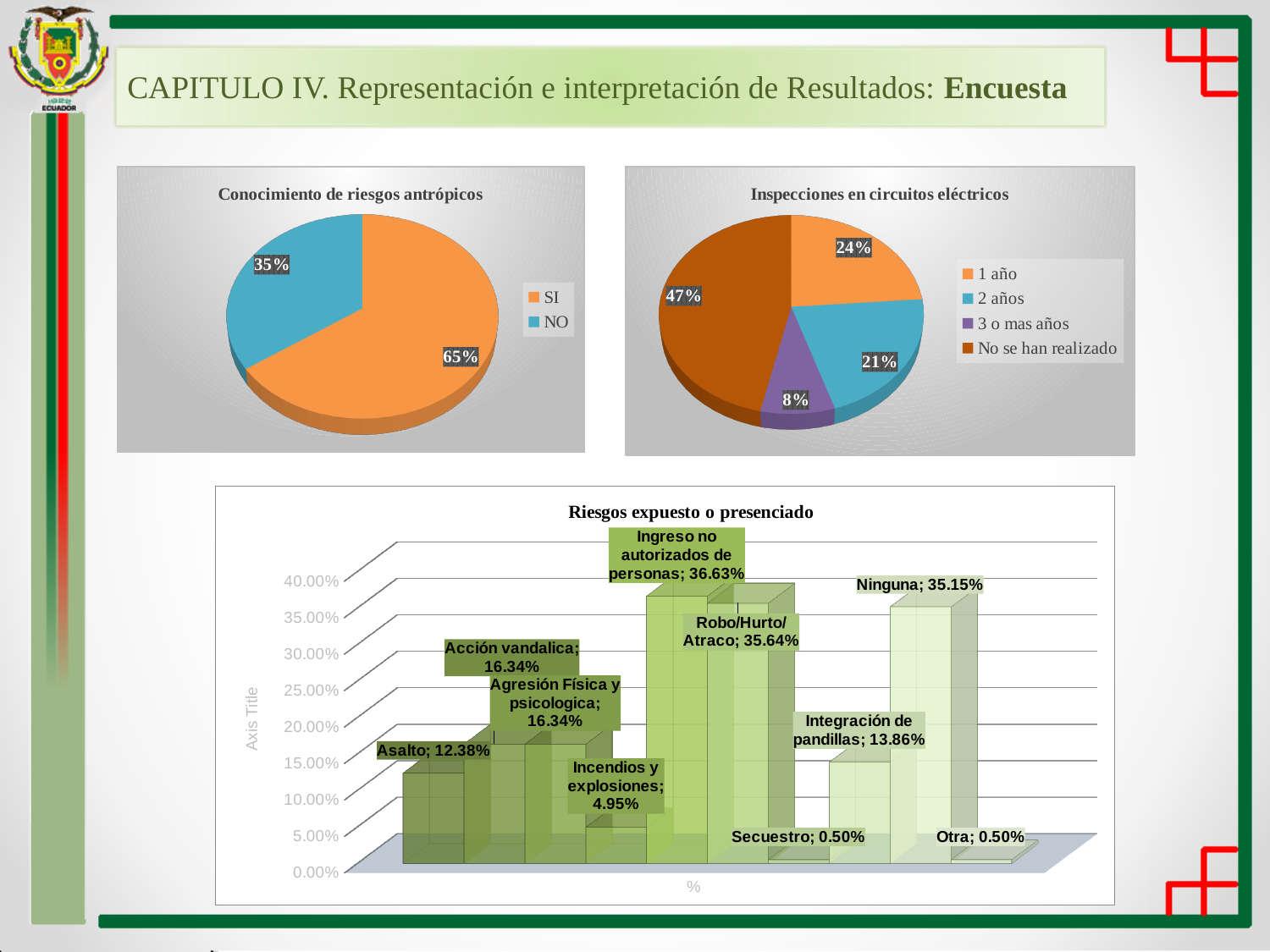
What kind of chart is 'Riesgos expuesto o presenciado'? Bar chart In the 'Riesgos expuesto o presenciado' chart, how many categories are plotted? 10 In the 'Riesgos expuesto o presenciado' chart, which category has the highest value? Ingreso no autorizados de personas In the 'Conocimiento de riesgos antrópicos' pie chart, what share is labelled for NO? 35% In the 'Inspecciones en circuitos eléctricos' pie chart, which category has the smallest slice? 3 o mas años How many entries does the legend of the 'Inspecciones en circuitos eléctricos' pie chart list? 4 In the 'Inspecciones en circuitos eléctricos' pie chart, what is the difference between the shares for '1 año' and '2 años'? 3% In the 'Riesgos expuesto o presenciado' chart, what is the value for 'Ingreso no autorizados de personas'? 36.63% In the 'Conocimiento de riesgos antrópicos' pie chart, what share is labelled for SI? 65% In the 'Riesgos expuesto o presenciado' chart, which is larger: 'Asalto' or 'Incendios y explosiones'? Asalto In the 'Riesgos expuesto o presenciado' chart, what is the value for 'Integración de pandillas'? 13.86% In the 'Inspecciones en circuitos eléctricos' pie chart, what share is labelled for 'No se han realizado'? 47%